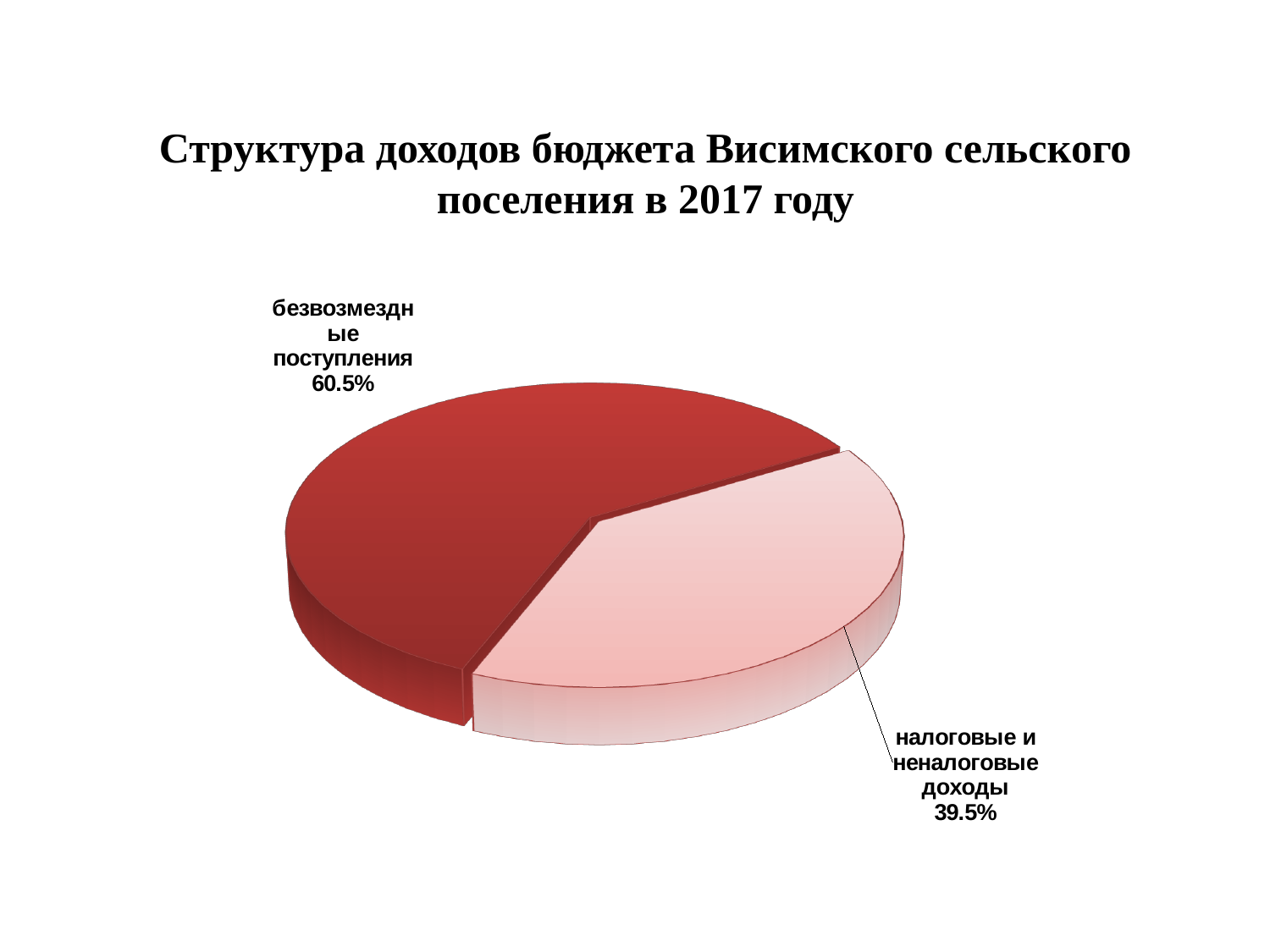
How many slices does the pie chart have? 2 Is the share for "безвозмездные поступления" greater or less than 50%? greater What is the total of the two slices' percentages? 100% Which slice is the smallest? налоговые и неналоговые доходы What is the title of the slide? Структура доходов бюджета Висимского сельского поселения в 2017 году What kind of chart is shown on the slide? pie chart What share of the pie is labelled "безвозмездные поступления"? 60.5% Which slice is shown in the lighter pink colour? налоговые и неналоговые доходы What is the difference in percentage points between the "безвозмездные поступления" slice and the "налоговые и неналоговые доходы" slice? 21 percentage points Which slice is the largest? безвозмездные поступления Which is larger: the share for "безвозмездные поступления" or the share for "налоговые и неналоговые доходы"? безвозмездные поступления What share of the pie is labelled "налоговые и неналоговые доходы"? 39.5%